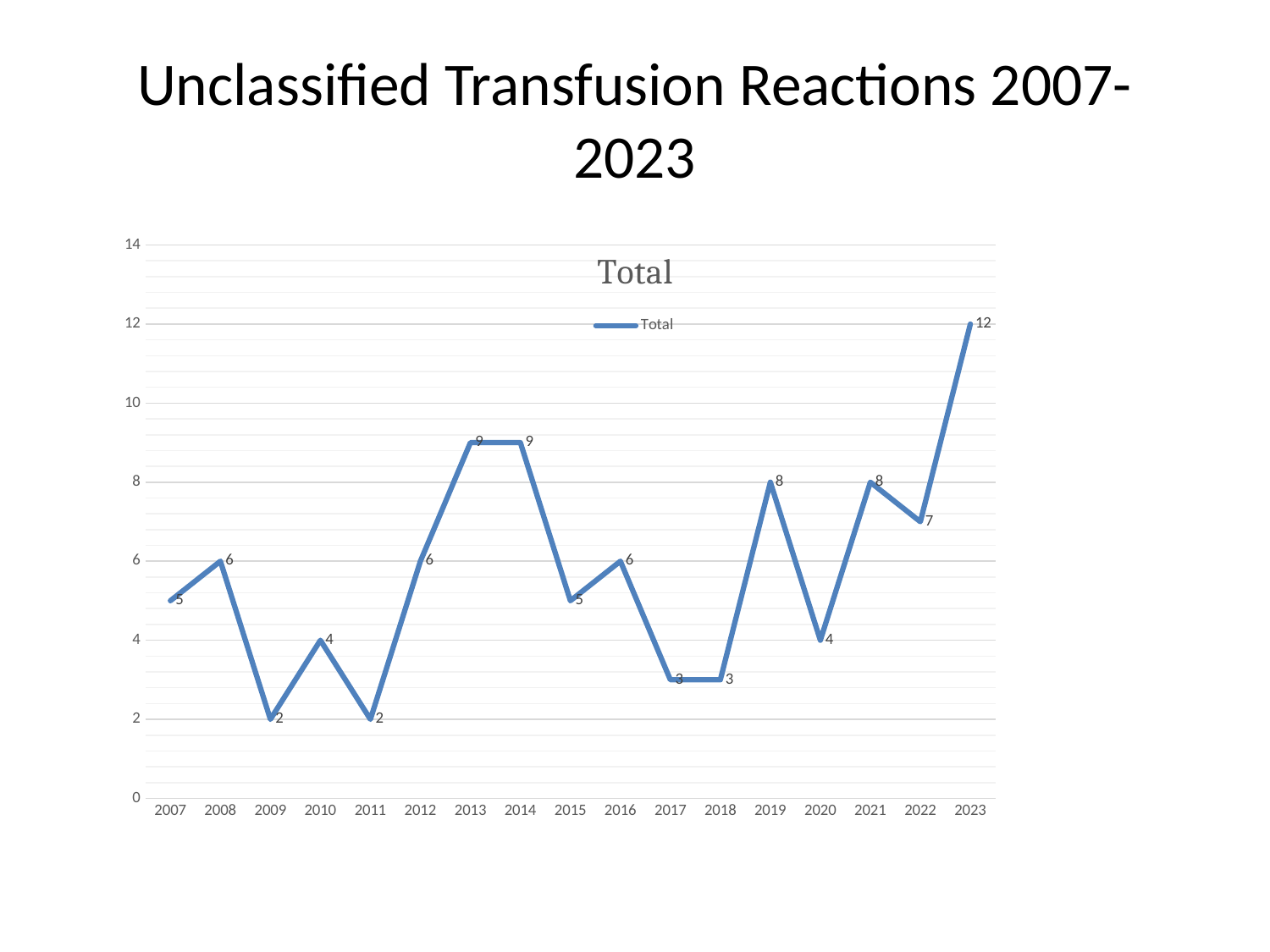
What is the title shown inside the chart area? Total What is the difference between the values for 2023 and 2022? 5 What is the value for 2023? 12 Do the values rise or fall from 2020 to 2021? rise Which is larger, the value for 2019 or the value for 2015? 2019 Which year has the highest value? 2023 How many series does the legend list? 1 What is the value for 2020? 4 Is the value for 2023 greater or less than 10? greater What is the value for 2013? 9 How many years are plotted on the x axis? 17 What kind of chart is shown? line chart